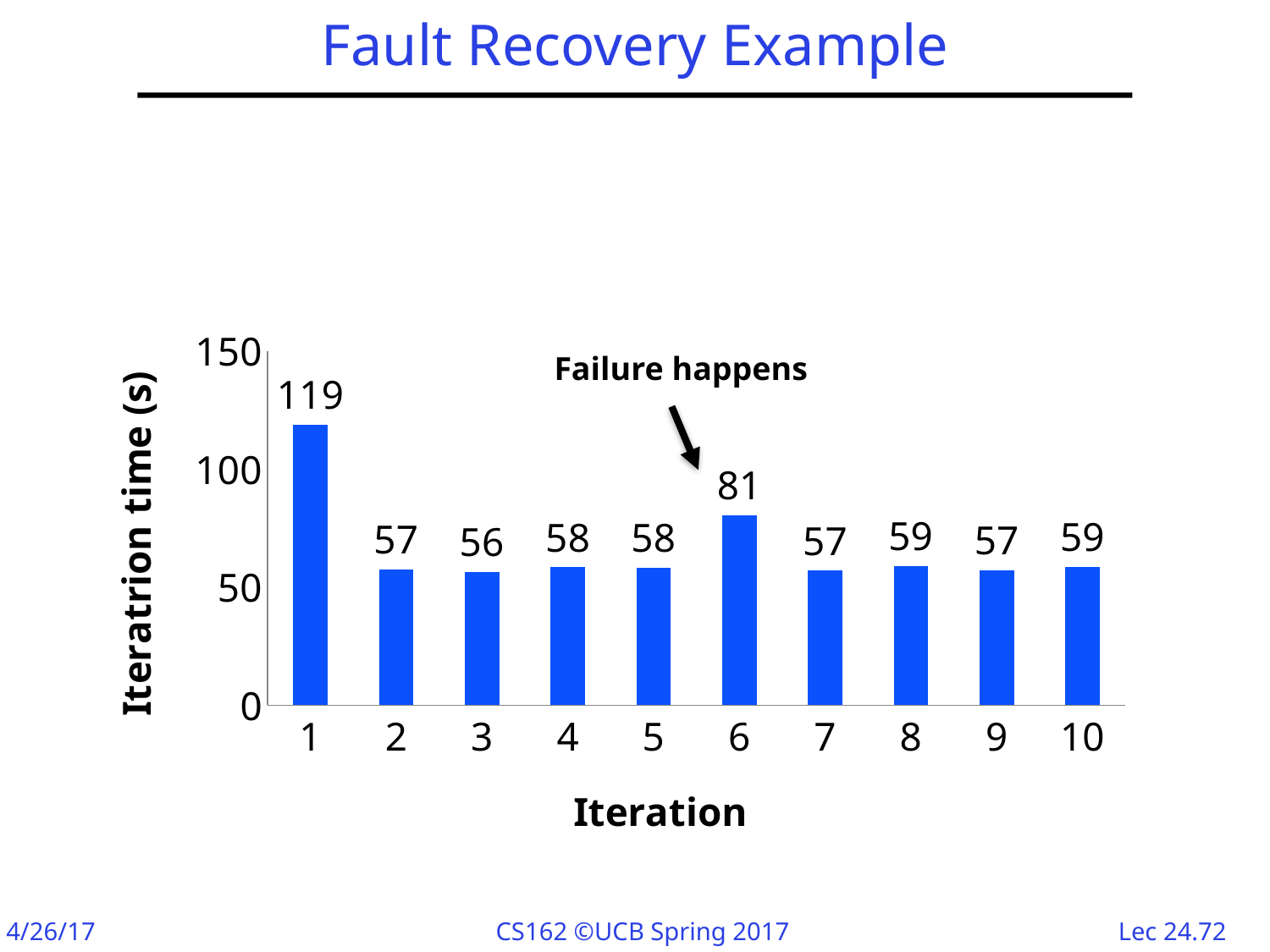
Which iteration has the highest iteration time? 1 What is the iteration time for iteration 6? 81 What is the iteration time for iteration 1? 119 Is the value for iteration 1 greater or less than 100? greater What is the iteration time for iteration 3? 56 What kind of chart is shown on the slide? Bar chart What is the difference in iteration time between iteration 1 and iteration 2? 62 What is the difference in iteration time between iteration 6 and iteration 7? 24 What is the label of the y axis? Iteratrion time (s) How many iterations are shown on the x axis? 10 Which iteration has the lowest iteration time? 3 Which has a larger iteration time, iteration 6 or iteration 8? Iteration 6